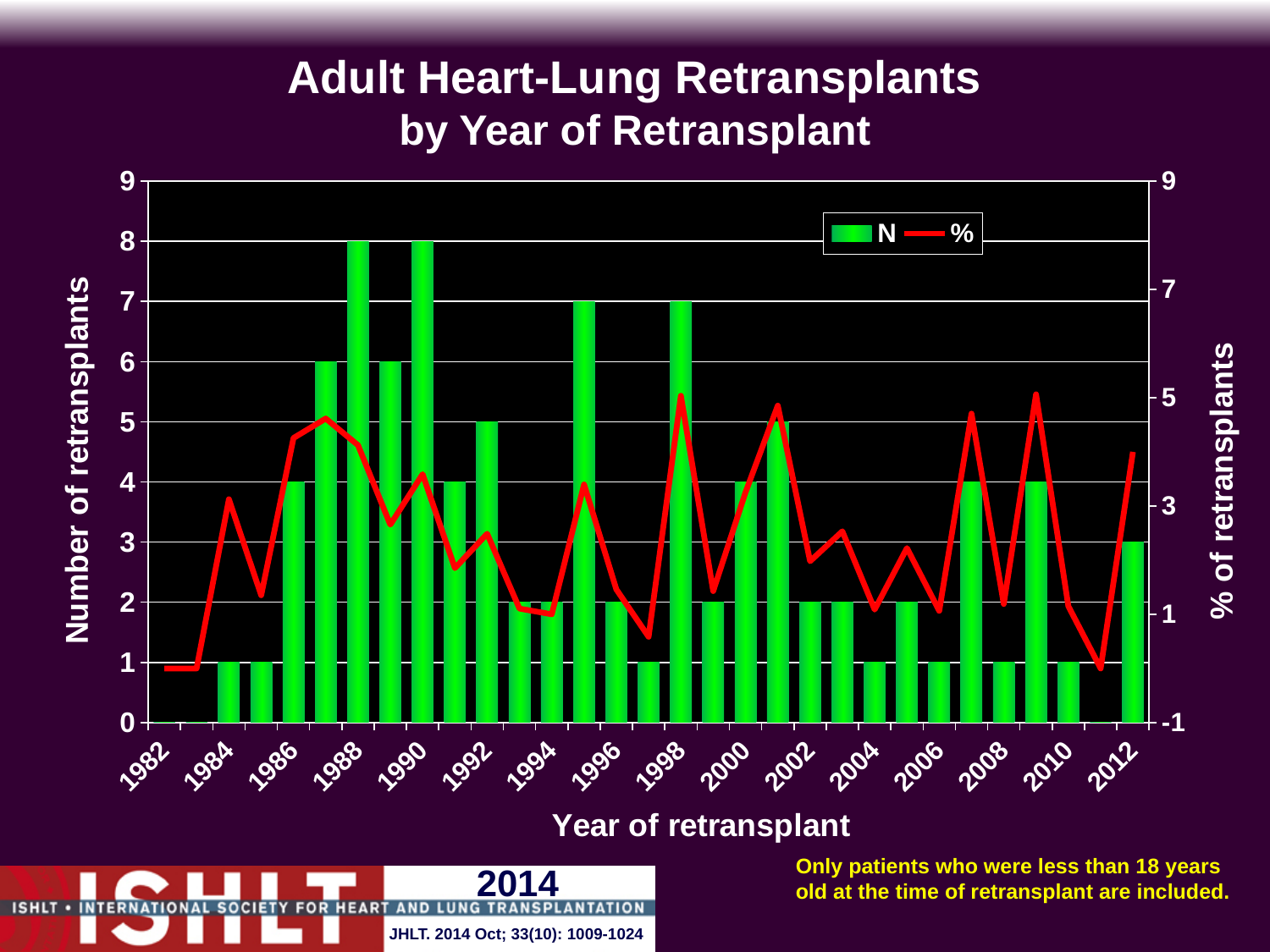
What is the number of retransplants (N) in 1988? 8 What is the difference between the number of retransplants in 1988 and in 2012? 5 What is the number of retransplants (N) in 2000? 4 What are the two series named in the legend? N and % Which year had more retransplants (N), 1998 or 2004? 1998 What kind of chart is shown on the slide? A bar chart with a line series What is the number of retransplants (N) in 1986? 4 How many series does the legend list? 2 What is the number of retransplants (N) in 1992? 5 What is the number of retransplants (N) in 2012? 3 What is the highest number of retransplants (N) reached in any year? 8 Is the % of retransplants value for 1998 greater or less than 4? greater